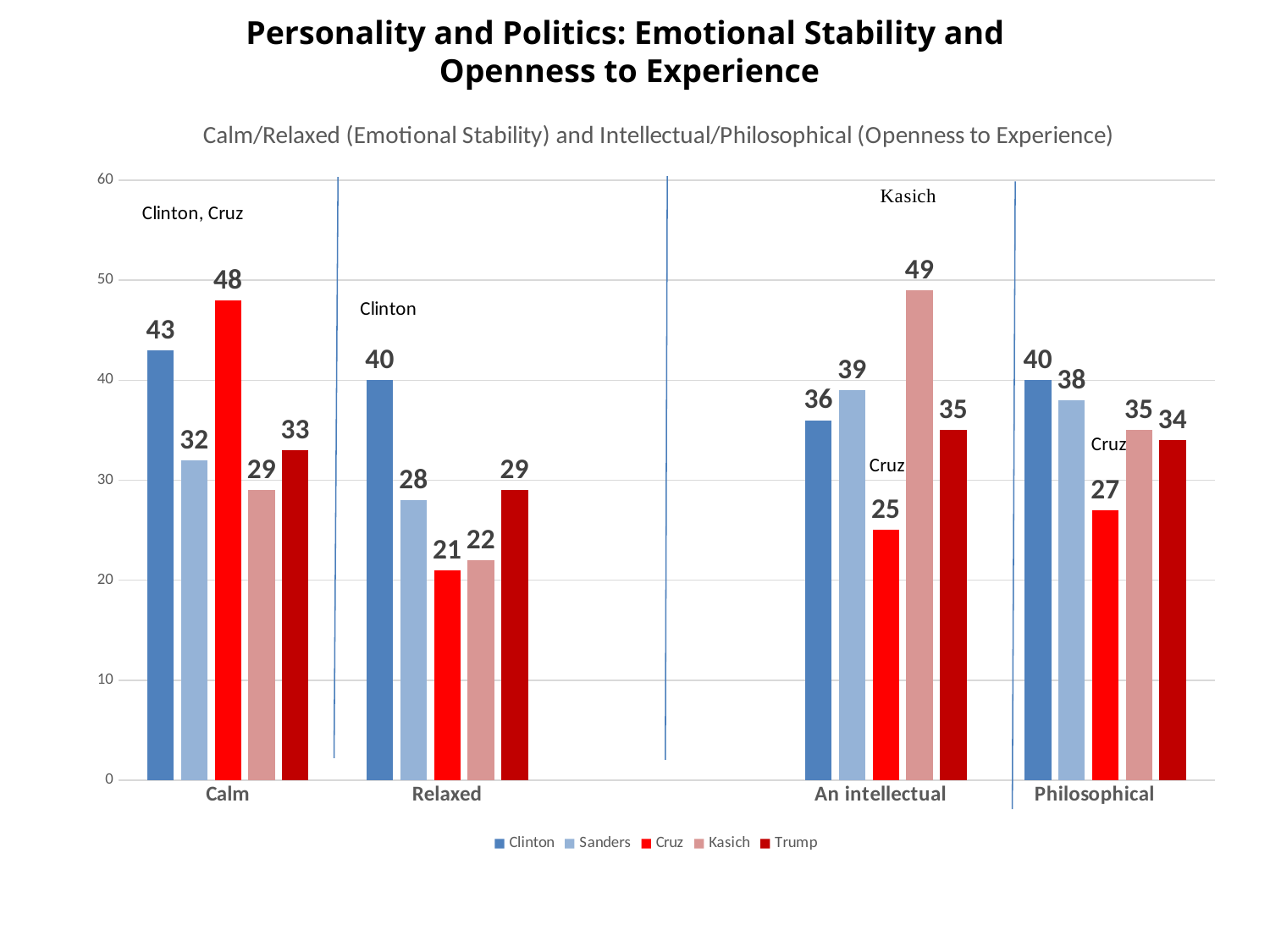
What is the difference between Cruz's and Kasich's values in the Calm category? 19 How many categories are shown on the x axis? 4 What is the value for Sanders in the Philosophical category? 38 Which is larger in the Relaxed category: Sanders or Trump? Trump Which candidate has the highest value in the Relaxed category? Clinton What is the chart's subtitle shown above the plot area? Calm/Relaxed (Emotional Stability) and Intellectual/Philosophical (Openness to Experience) How many series does the legend list? 5 What is the value for Cruz in the Calm category? 48 What kind of chart is shown on the slide? Bar chart Which candidate has the lowest value in the An intellectual category? Cruz What is the difference between Clinton's and Cruz's values in the Philosophical category? 13 What is the value for Kasich in the An intellectual category? 49